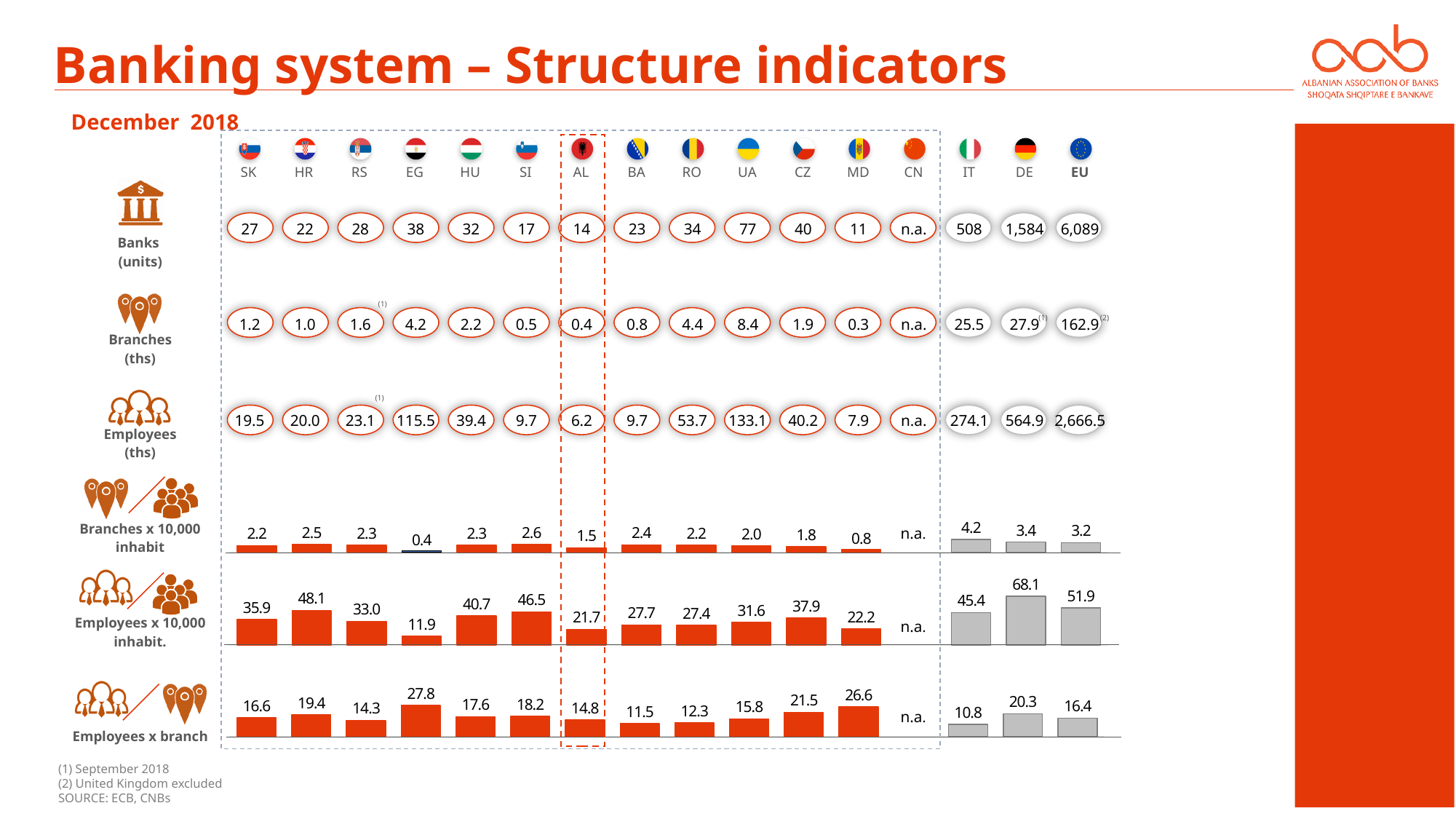
In the Employees x branch chart, which country has the lowest value? IT In the Branches x 10,000 inhabit chart, which country has the lowest value? EG In the Branches x 10,000 inhabit chart, what is the value for AL? 1.5 In the Employees x 10,000 inhabit. chart, what is the difference between DE and AL? 46.4 In the Employees x 10,000 inhabit. chart, which country has the highest value? DE In the Employees x branch chart, which is larger, EG or MD? EG In the Branches x 10,000 inhabit chart, what is the difference between HR and SK? 0.3 In the bar charts, what colour are the bars for IT, DE and EU? grey What kind of chart is used for the Employees x branch row? bar chart In the Employees x branch chart, what is the value for EU? 16.4 In the Employees x 10,000 inhabit. chart, what is the value for SI? 46.5 In the Branches x 10,000 inhabit chart, which country has the highest value? IT